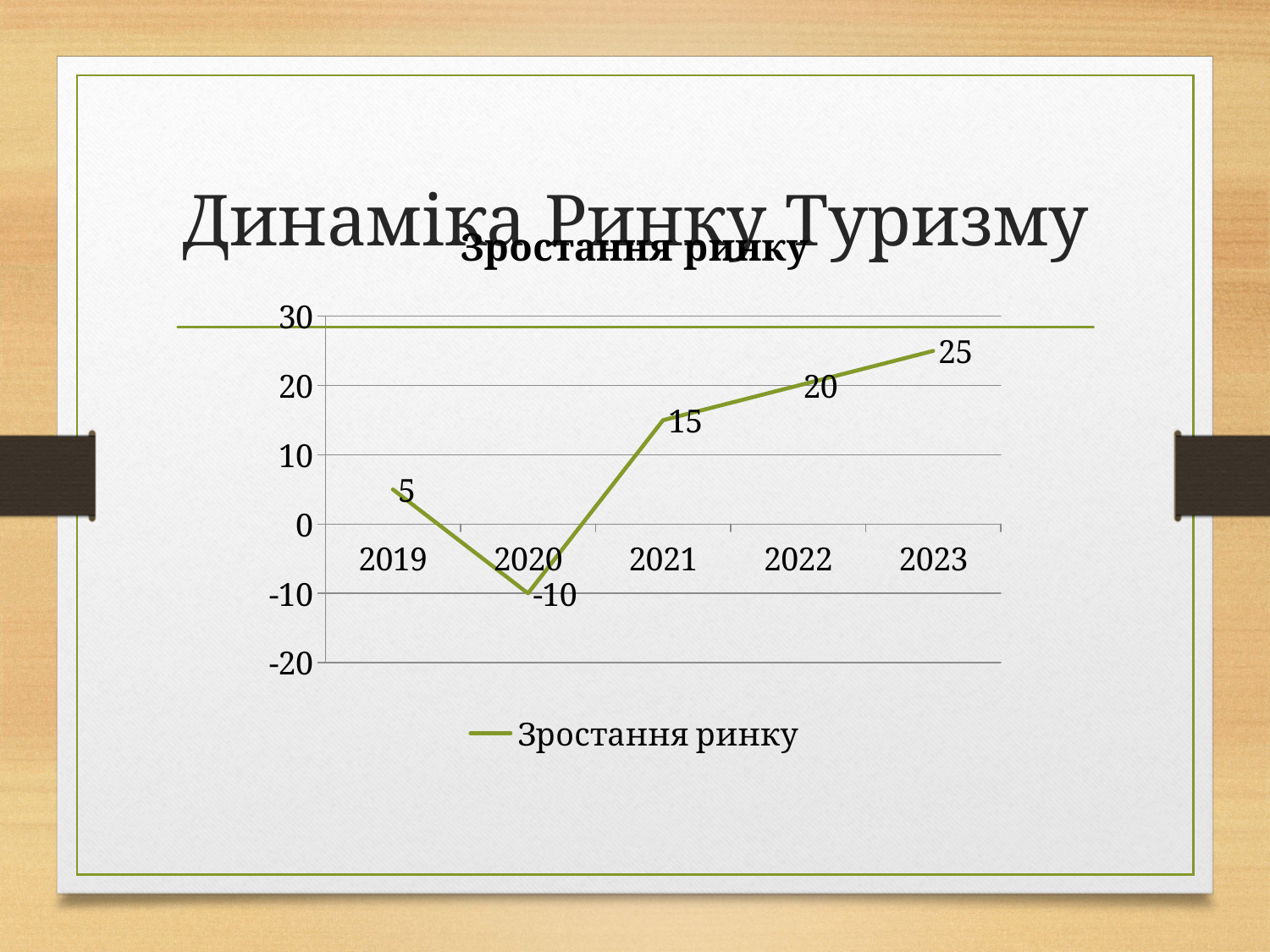
Do the values rise or fall from 2020 to 2023? rise What is the difference between the values for 2021 and 2020? 25 What is the difference between the values for 2023 and 2022? 5 How many years are plotted on the chart? 5 What is the value for 2019? 5 What kind of chart is shown? line chart Which year has the highest value? 2023 What is the value for 2023? 25 What is the value for 2021? 15 Which is larger, the value for 2019 or the value for 2022? 2022 Which year has the lowest value? 2020 What is the value for 2020? -10